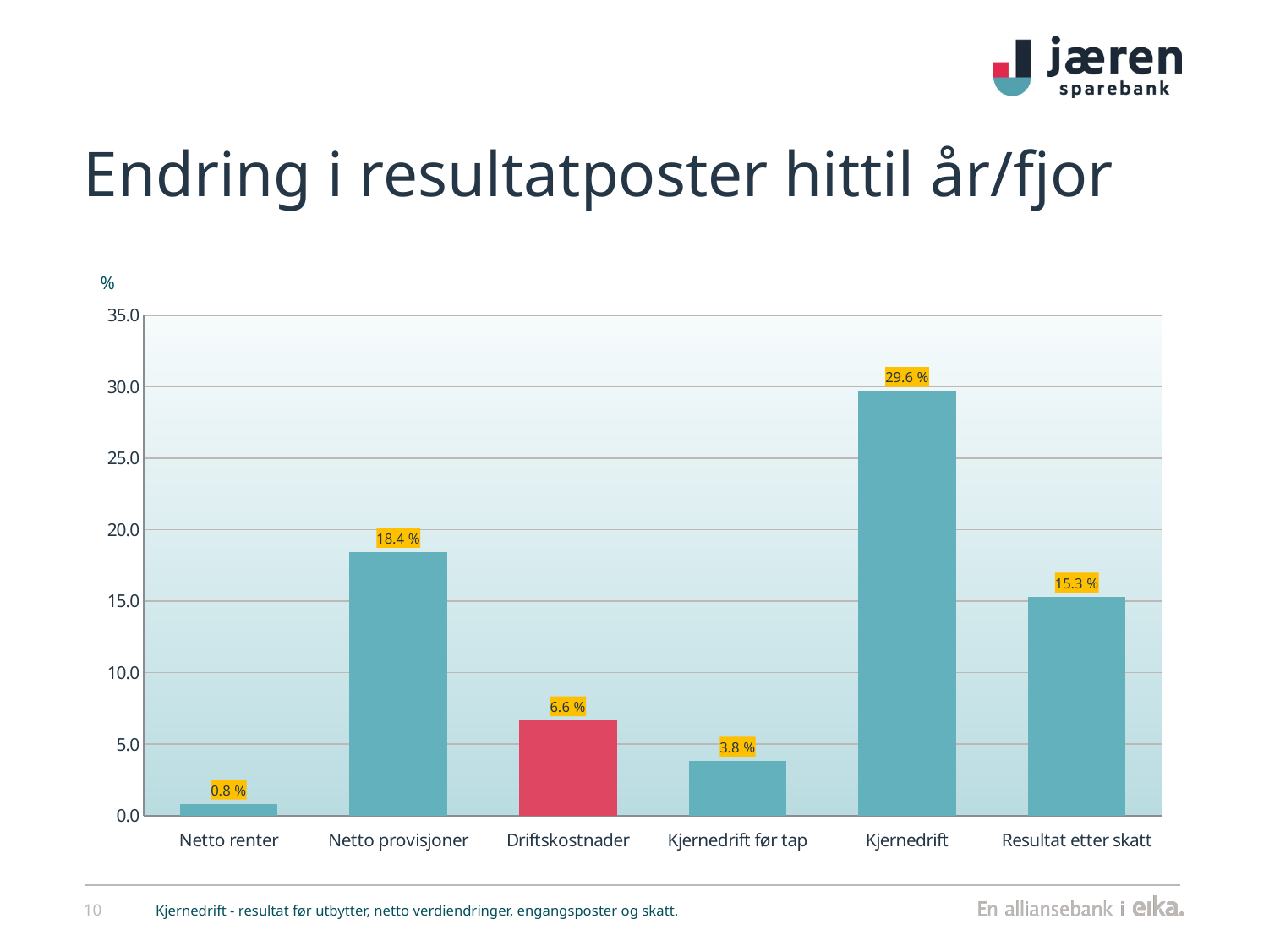
What is the value for Kjernedrift? 29.6 % Which is larger, the value for Driftskostnader or the value for Kjernedrift før tap? Driftskostnader What is the value for Resultat etter skatt? 15.3 % What is the difference between the values for Kjernedrift and Resultat etter skatt? 14.3 % What is the value for Netto provisjoner? 18.4 % Which category has the lowest value? Netto renter What kind of chart is shown on the slide? bar chart Which category has the highest value? Kjernedrift Which bar is coloured red instead of teal? Driftskostnader Is the value for Netto provisjoner greater or less than 20.0? less How many categories are shown on the x axis? 6 What is the value for Driftskostnader? 6.6 %